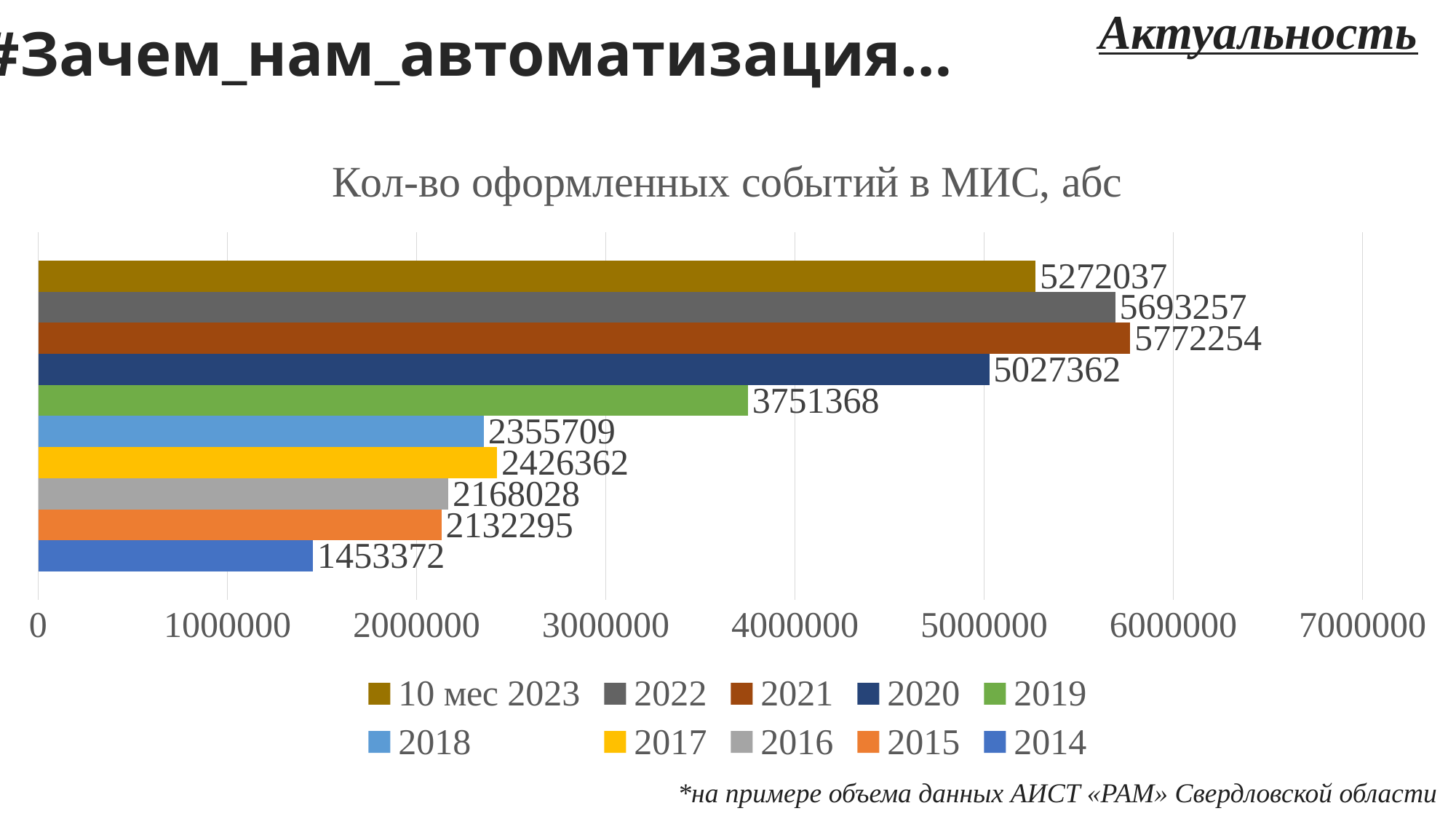
What kind of chart is shown on the slide? bar chart Which is larger, the value for 2017 or the value for 2018? 2017 What is the value for 2021? 5772254 What is the difference between the values for 2021 and 2022? 78997 What is the value for 2014? 1453372 Is the value for 2019 greater or less than 3000000? greater How many bars are shown in the chart? 10 Which year has the lowest value? 2014 What is the title of the chart? Кол-во оформленных событий в МИС, абс What is the value for 2019? 3751368 Which year has the highest value? 2021 What is the value for 10 мес 2023? 5272037